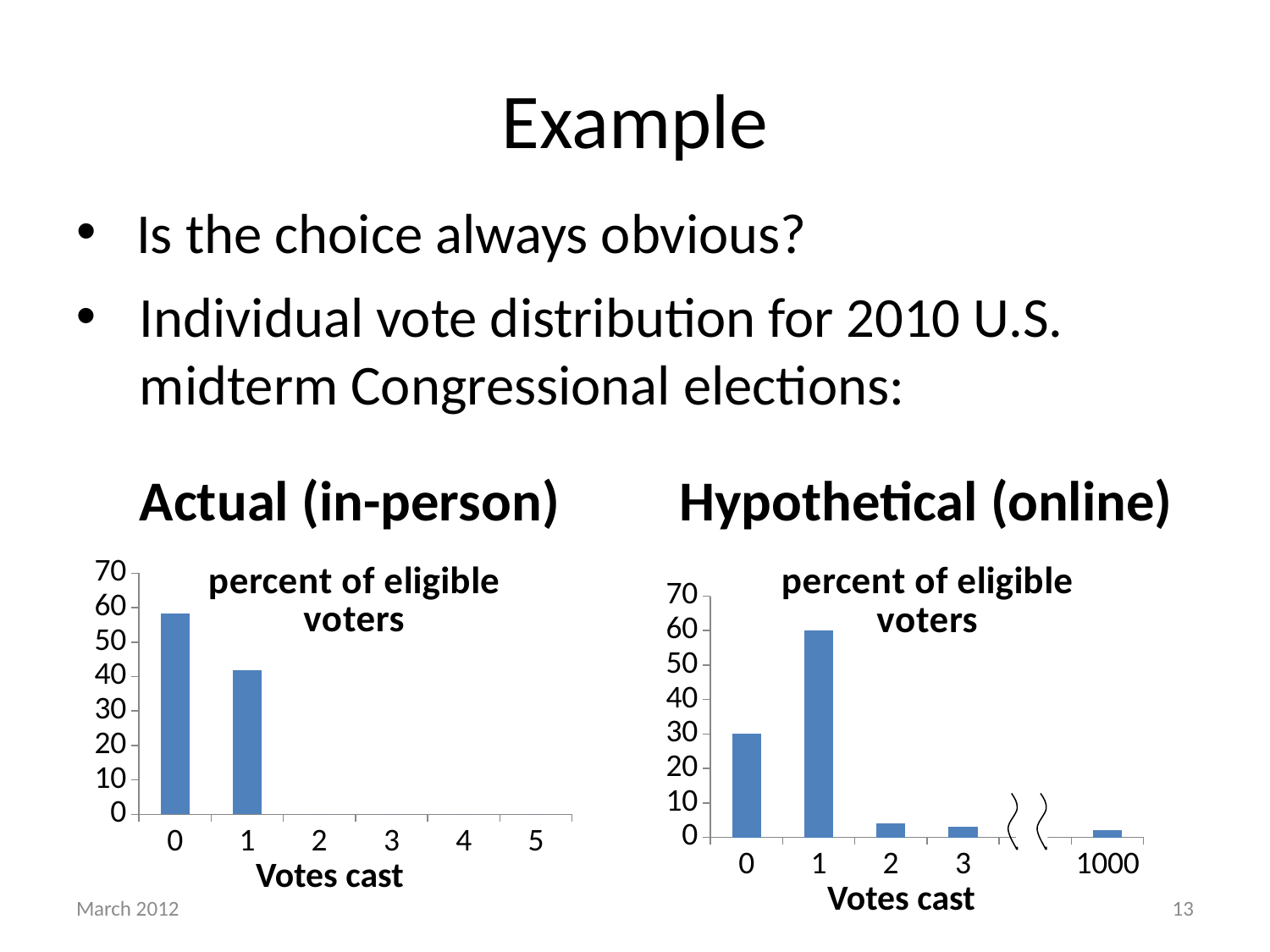
How many votes-cast categories are shown on the x axis of the Actual (in-person) chart? 6 In the Hypothetical (online) chart, what is the percent of eligible voters for 1 vote cast? 60 In the Actual (in-person) chart, which is larger, the value for 0 votes cast or for 1 vote cast? 0 In the Hypothetical (online) chart, which votes-cast category has the highest percent of eligible voters? 1 What is the x-axis title of the Hypothetical (online) chart? Votes cast In the Hypothetical (online) chart, what is the percent of eligible voters for 0 votes cast? 30 In the Actual (in-person) chart, is the value for 1 vote cast greater or less than 50? less In the Actual (in-person) chart, is the value for 0 votes cast greater or less than 50? greater How many votes-cast categories are shown on the x axis of the Hypothetical (online) chart? 5 What kind of chart is the Actual (in-person) chart? bar chart In the Actual (in-person) chart, which votes-cast category has the highest percent of eligible voters? 0 In the Hypothetical (online) chart, is the value for 2 votes cast greater or less than 10? less